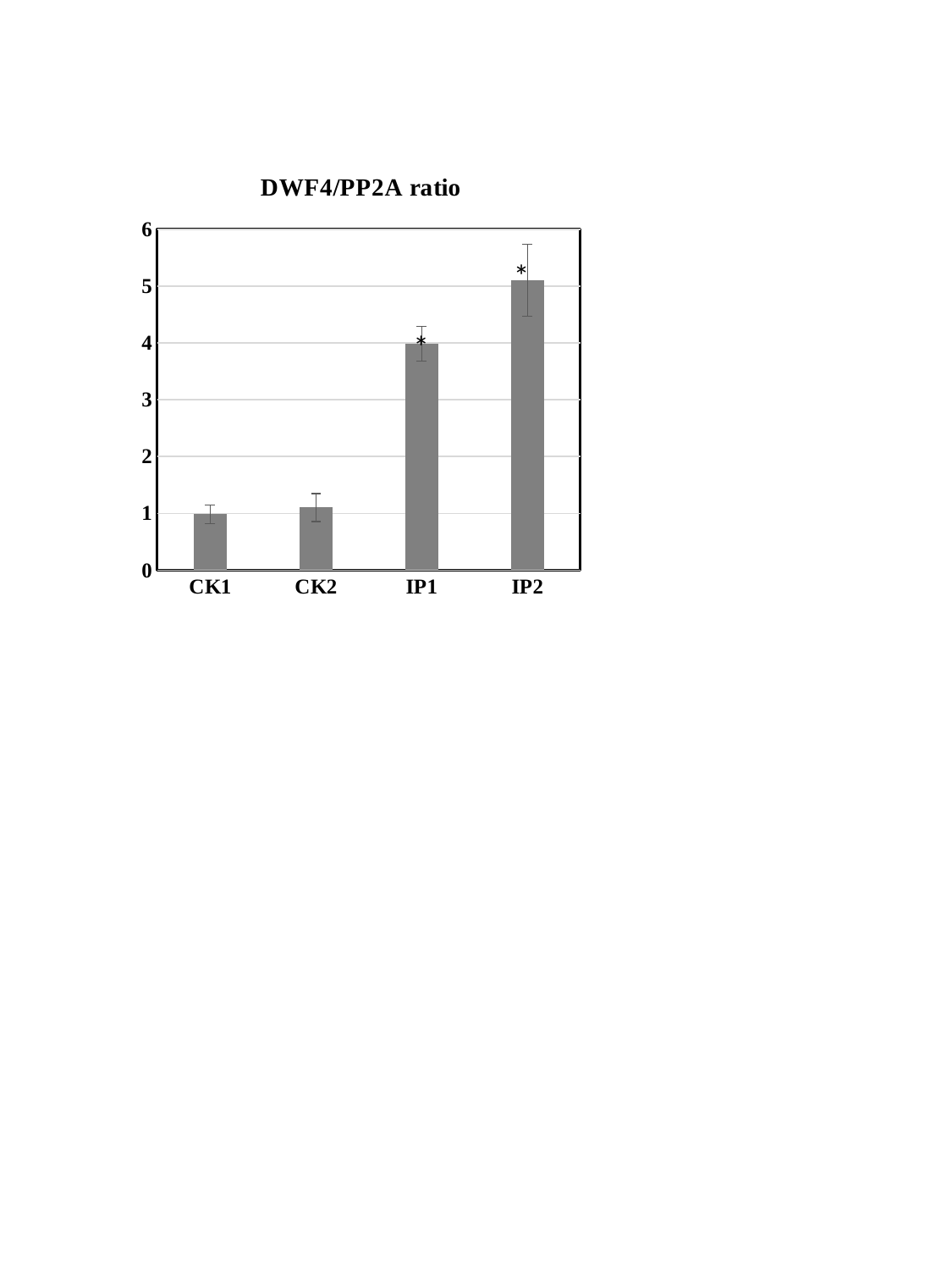
How many categories are shown on the x axis? 4 Is the value for CK2 greater or less than 2? less Is the value for IP1 greater or less than 3? greater Which is larger, the value for IP1 or the value for IP2? IP2 Which is larger, the value for CK1 or the value for IP1? IP1 Do the values generally rise or fall from CK1 to IP2 along the x axis? rise Is the value for CK1 greater or less than 2? less What is the title of the chart? DWF4/PP2A ratio Which bars are marked with an asterisk? IP1 and IP2 Which category has the highest DWF4/PP2A ratio? IP2 What kind of chart is shown on the slide? bar chart